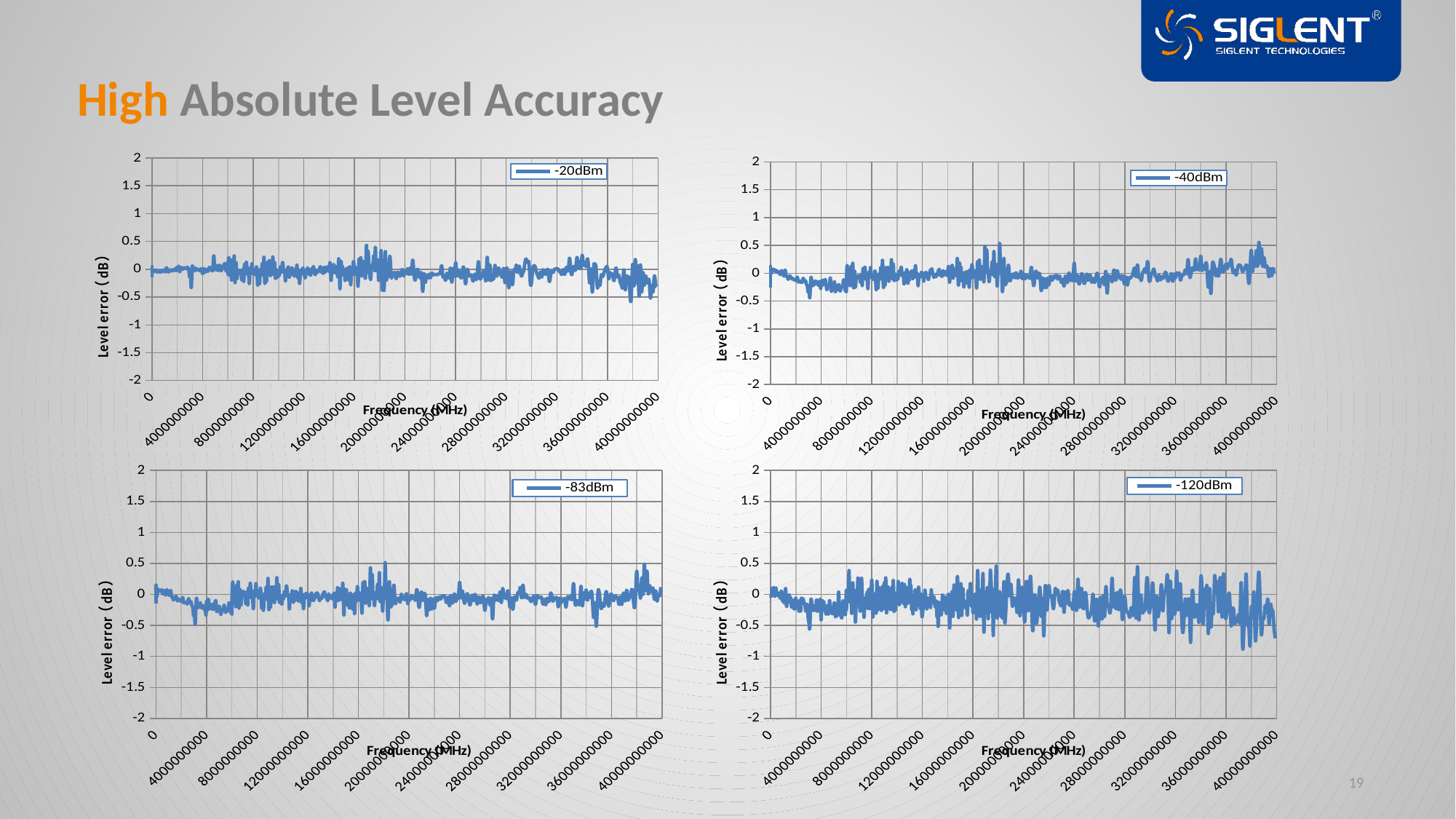
In the -83dBm chart, is the level error at a frequency of 800000000 greater or less than 1? less How many charts are shown on the slide? 4 How many series does the legend of the top-right chart list? 1 In the -20dBm chart, is the level error at a frequency of 2000000000 greater or less than 1? less In the -120dBm chart, is the level error at a frequency of 3600000000 greater or less than -1.5? greater What kind of chart is the top-left chart with the -20dBm legend? line chart How many series does the legend of the bottom-left chart list? 1 What kind of chart is the bottom-right chart with the -120dBm legend? line chart What is the legend entry of the bottom-right chart? -120dBm What is the legend entry of the bottom-left chart? -83dBm